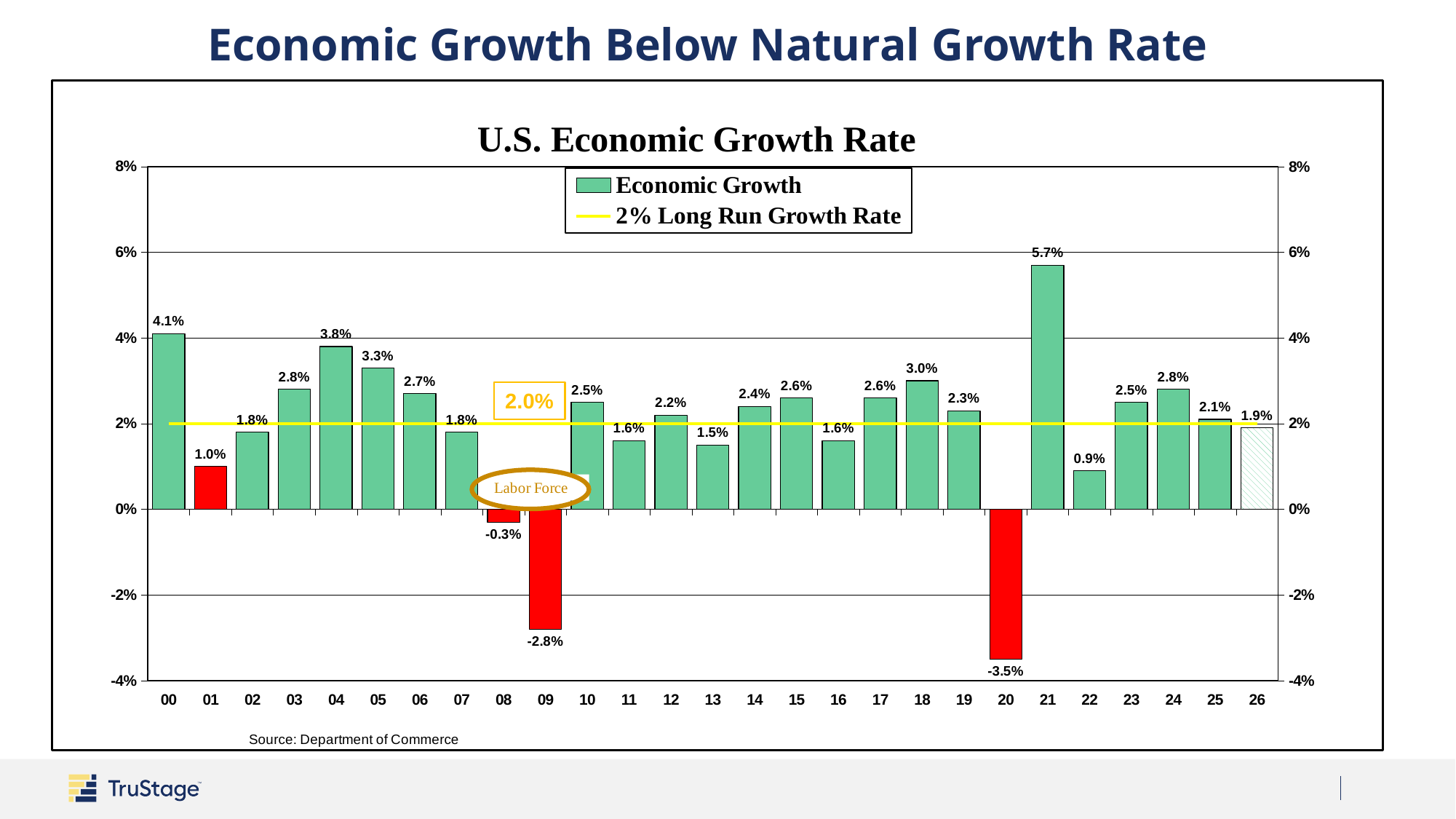
What kind of chart is used to show the economic growth rate? Bar chart Which year has the highest economic growth rate? 21 How many series does the legend list? 2 What is the difference between the economic growth rate in 00 and in 01? 3.1 percentage points What is the economic growth rate shown for 21? 5.7% What is the difference between the economic growth rate in 21 and in 20? 9.2 percentage points Which year has a higher economic growth rate, 04 or 05? 04 Which year has the lowest economic growth rate? 20 What is the economic growth rate shown for 13? 1.5% How many years are shown on the x axis of the chart? 27 What is the economic growth rate shown for 26? 1.9% What is the economic growth rate shown for 09? -2.8%